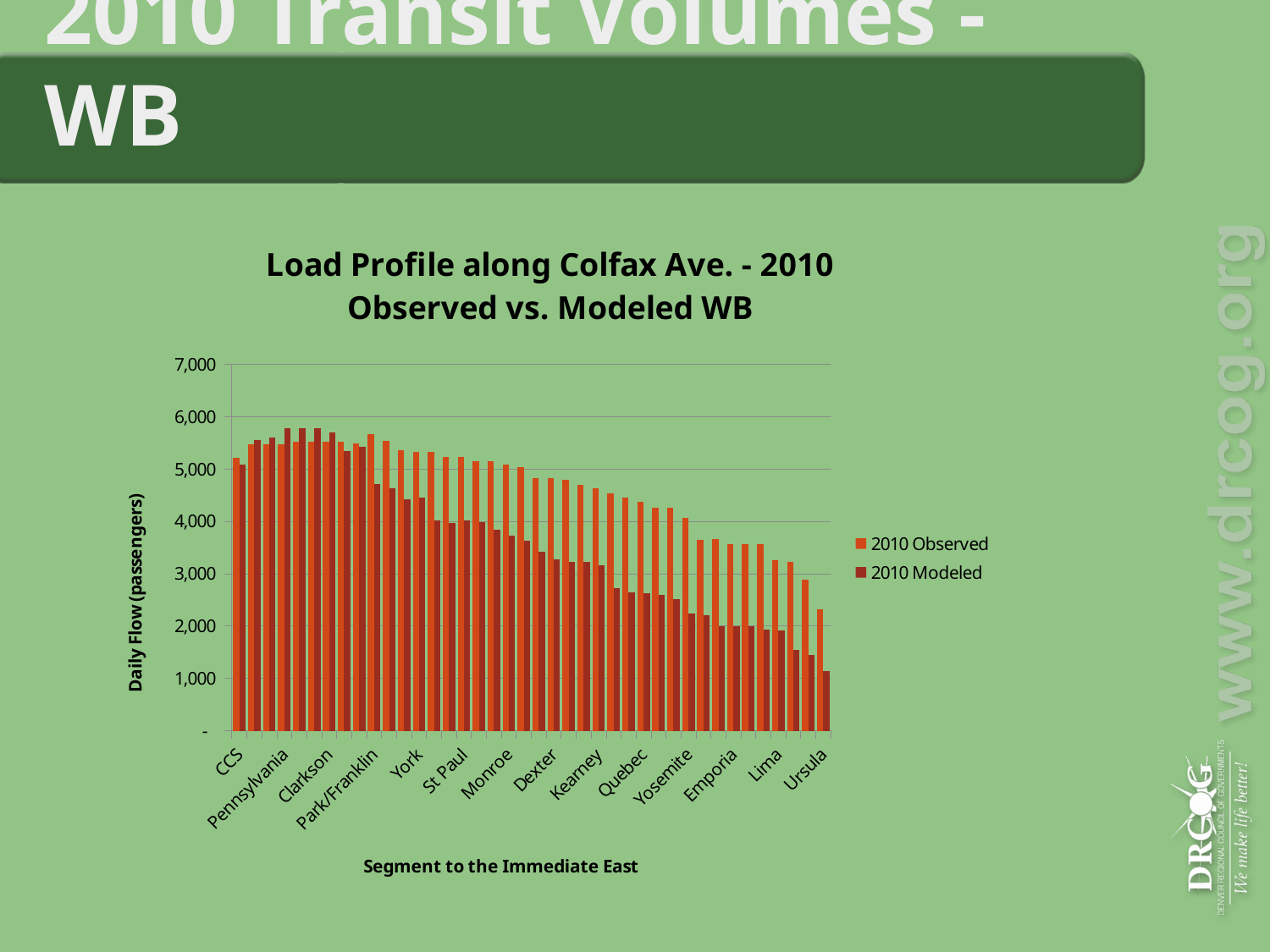
What is the title of the vertical axis? Daily Flow (passengers) Is the 2010 Modeled value for Quebec greater or less than 3,000? less Which labeled segment has the lowest 2010 Modeled value? Ursula Do the 2010 Observed values generally rise or fall moving from CCS to Ursula along the x axis? fall Which labeled segment has the lowest 2010 Observed value? Ursula Is the 2010 Observed value for Ursula greater or less than 3,000? less At Lima, which is larger: the 2010 Observed value or the 2010 Modeled value? 2010 Observed What are the two series named in the legend? 2010 Observed and 2010 Modeled How many series does the legend list? 2 What kind of chart is shown on the slide? bar chart